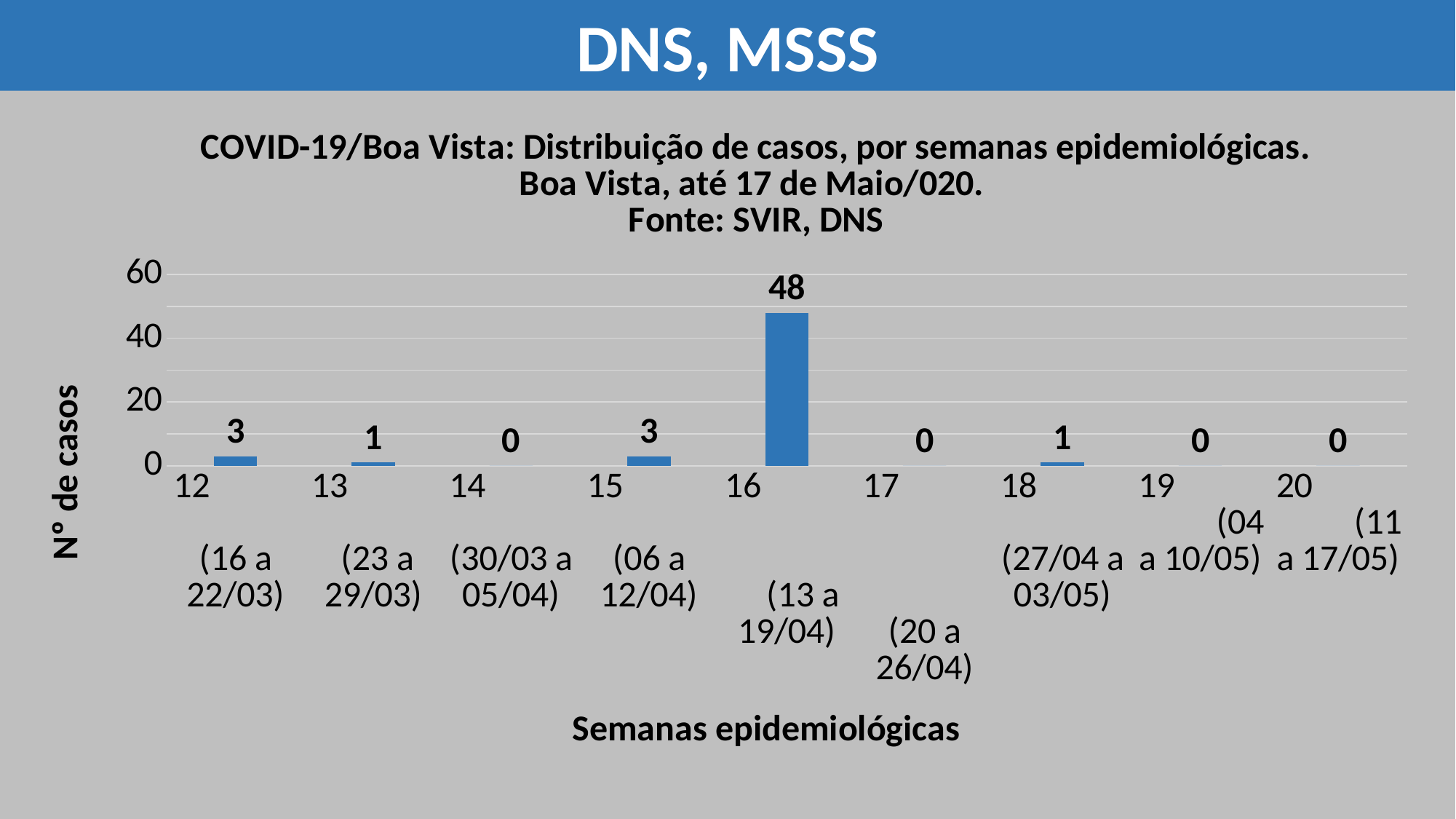
What kind of chart is shown on the slide? bar chart What is the label of the y axis? N° de casos How many epidemiological weeks have 0 cases? 4 What is the number of cases for epidemiological week 14 (30/03 a 05/04)? 0 What is the difference in cases between week 16 and week 15? 45 Which has more cases, week 12 or week 13? week 12 What is the number of cases for epidemiological week 18 (27/04 a 03/05)? 1 How many epidemiological weeks are plotted on the x axis? 9 What is the number of cases for epidemiological week 16 (13 a 19/04)? 48 Which epidemiological week has the highest number of cases? 16 What is the number of cases for epidemiological week 12 (16 a 22/03)? 3 Is the value for week 16 greater or less than 40? greater